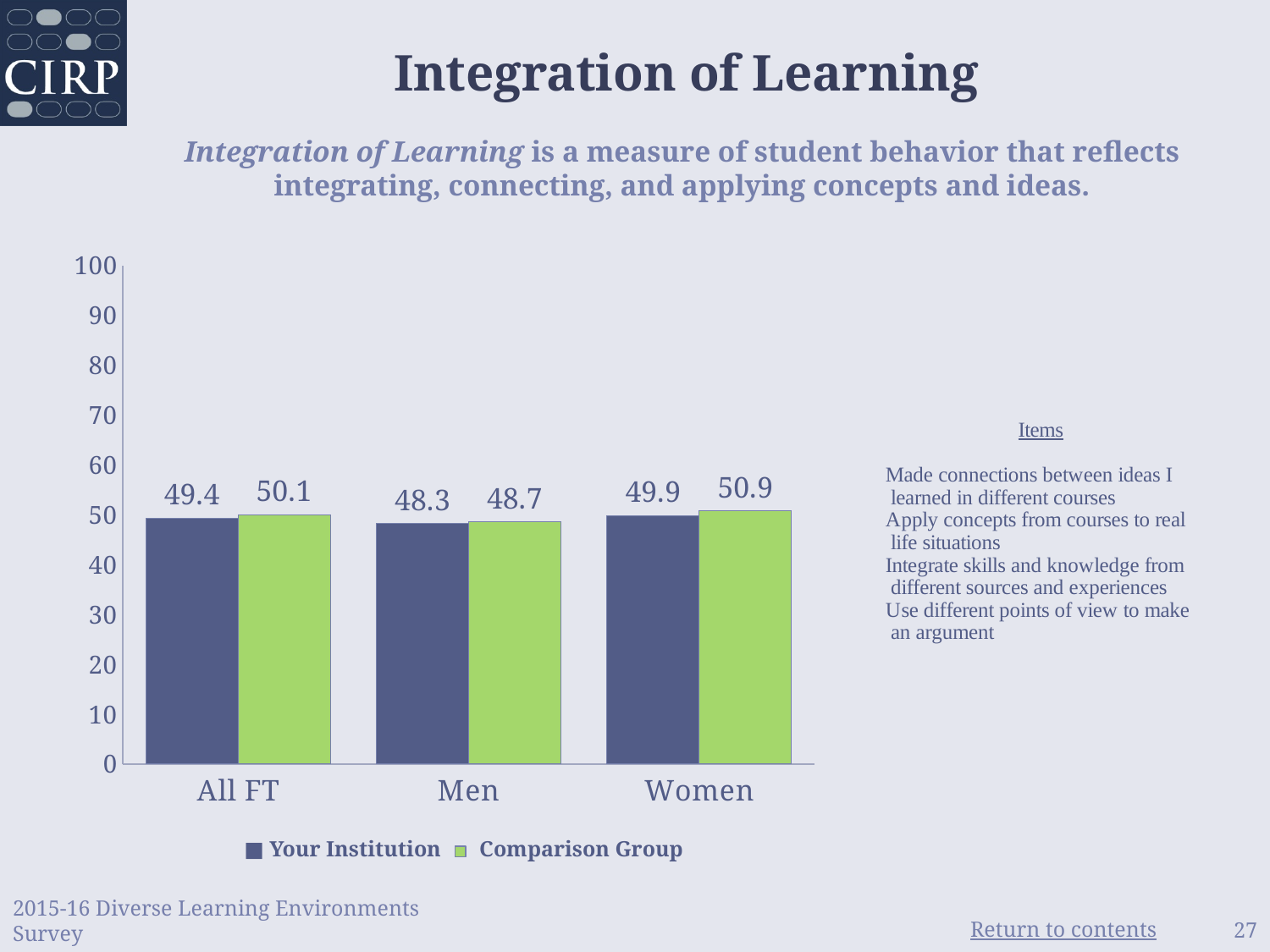
What is the value for Your Institution in the Men category? 48.3 Which category has the lowest Your Institution value? Men What is the title of the slide? Integration of Learning Which category has the highest Comparison Group value? Women Which is larger for Men: Your Institution or Comparison Group? Comparison Group What kind of chart is shown on the slide? bar chart How many categories are shown on the x axis? 3 How many series does the legend list? 2 What is the difference between the Comparison Group and Your Institution values for Women? 1.0 What is the difference between the Comparison Group and Your Institution values for All FT? 0.7 What is the value for Your Institution in the All FT category? 49.4 What is the value for Comparison Group in the Women category? 50.9